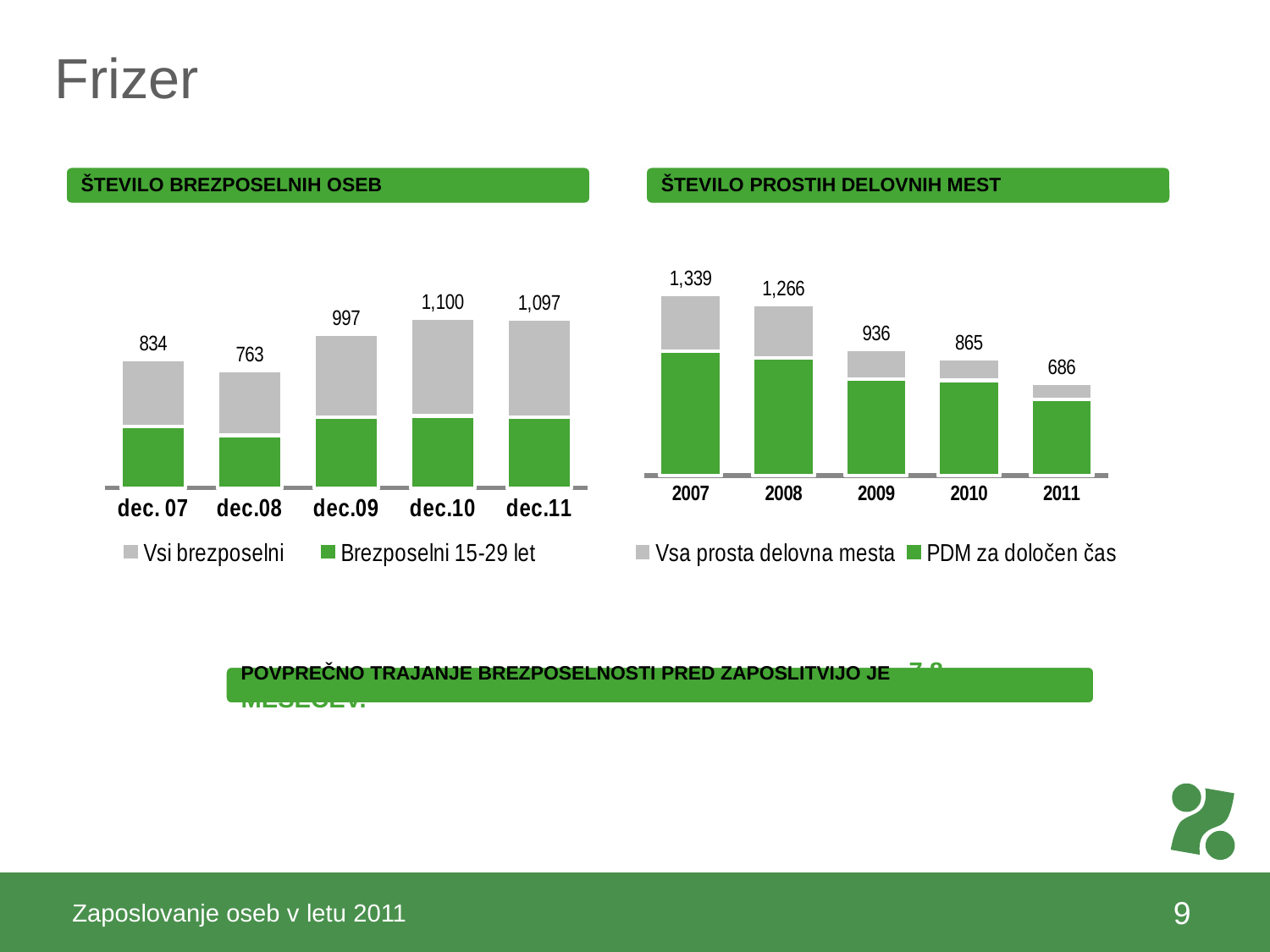
In the ŠTEVILO PROSTIH DELOVNIH MEST chart, what value is labelled for 2009? 936 In the ŠTEVILO BREZPOSELNIH OSEB chart, which period has the lowest labelled value? dec.08 In the ŠTEVILO PROSTIH DELOVNIH MEST chart, which year has the highest labelled value? 2007 In the ŠTEVILO PROSTIH DELOVNIH MEST chart, do the labelled values rise or fall from 2007 to 2011? fall In the ŠTEVILO BREZPOSELNIH OSEB chart, what is the difference between the labelled values for dec.10 and dec. 07? 266 In the ŠTEVILO BREZPOSELNIH OSEB chart, how many periods are shown on the x axis? 5 What kind of chart is the ŠTEVILO PROSTIH DELOVNIH MEST chart? bar chart In the ŠTEVILO PROSTIH DELOVNIH MEST chart, which is larger, the labelled value for 2008 or for 2010? 2008 In the ŠTEVILO BREZPOSELNIH OSEB chart, what value is labelled for dec.10? 1,100 In the ŠTEVILO PROSTIH DELOVNIH MEST chart, what is the difference between the labelled values for 2007 and 2011? 653 In the ŠTEVILO BREZPOSELNIH OSEB chart, how many series does the legend list? 2 In the ŠTEVILO BREZPOSELNIH OSEB chart, what value is labelled for dec.09? 997